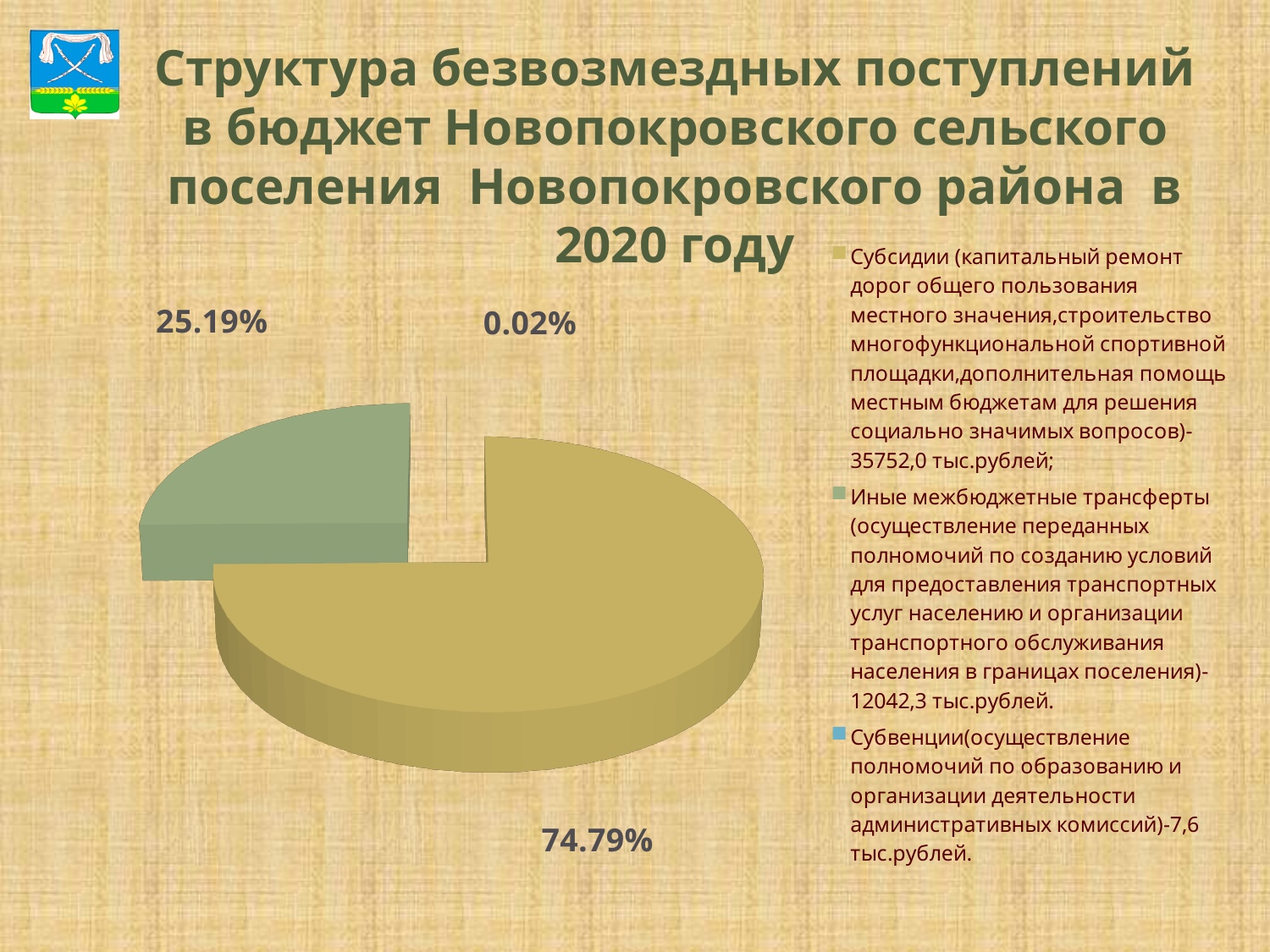
According to the legend, what amount in тыс.рублей corresponds to Субсидии? 35752,0 тыс.рублей What share of the pie does the Субвенции slice represent? 0.02% What share of the pie does the Иные межбюджетные трансферты slice represent? 25.19% By how many percentage points does the Субсидии share exceed the Иные межбюджетные трансферты share? 49.60% Which year does the chart title say the structure of gratuitous receipts refers to? 2020 What kind of chart is shown on the slide? Pie chart Which is larger: the share for Субсидии or the share for Иные межбюджетные трансферты? Субсидии How many entries does the legend of the pie chart list? 3 What share of the pie does the Субсидии slice represent? 74.79% Which category has the largest share of the pie chart? Субсидии How many slices does the pie chart have? 3 Which category has the smallest share of the pie chart? Субвенции